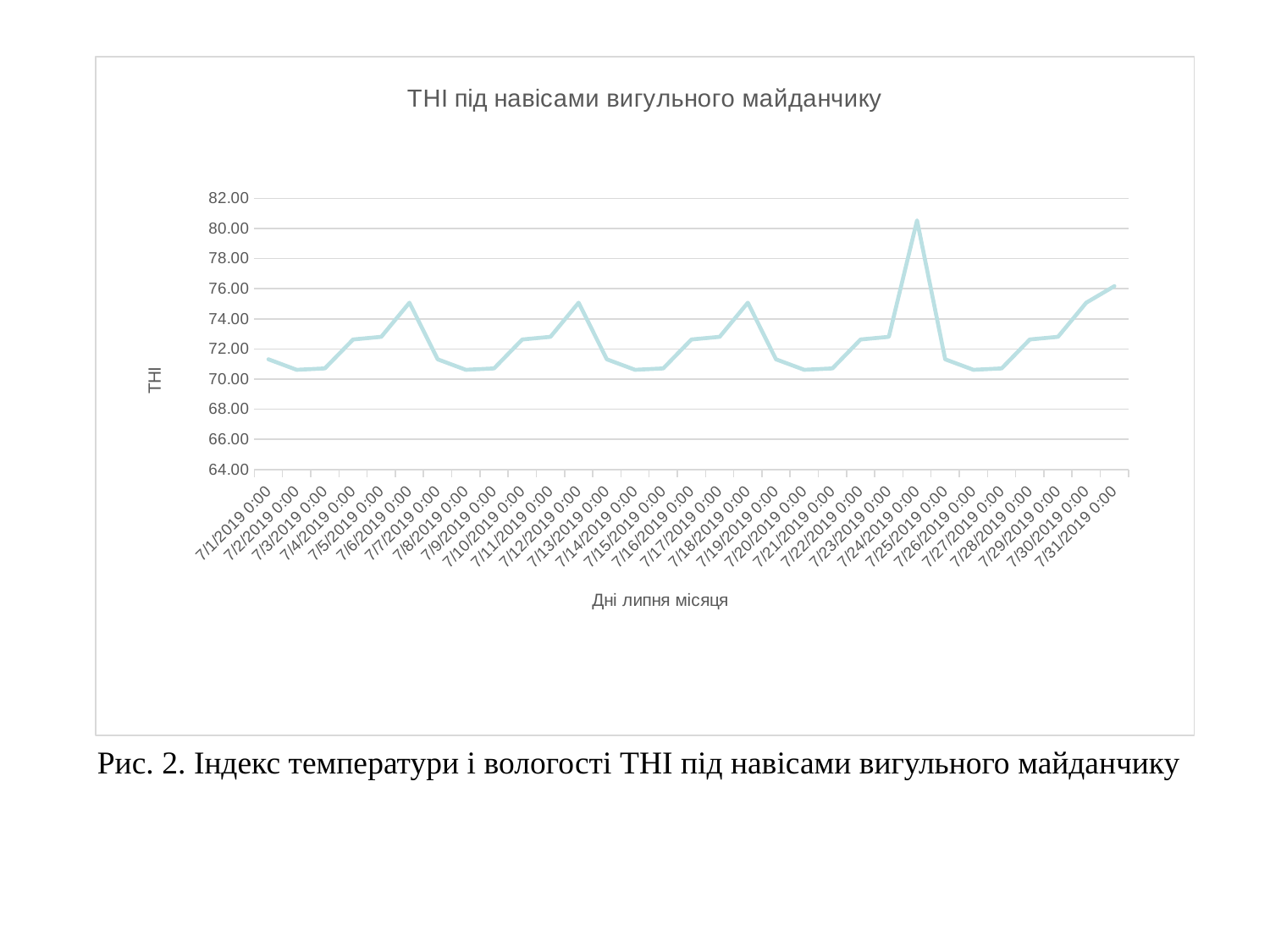
Which is larger, the value for 7/25/2019 0:00 or the value for 7/6/2019 0:00? 7/6/2019 0:00 What kind of chart is shown on the slide? line chart What is the label of the x axis? Дні липня місяця Is the value for 7/31/2019 0:00 greater or less than 74.00? greater Is the value for 7/6/2019 0:00 greater or less than 74.00? greater What is the title of the chart? THI під навісами вигульного майданчику Is the value for 7/1/2019 0:00 greater or less than 72.00? less How many data points are plotted on the line? 31 Do the values rise or fall from 7/27/2019 0:00 to 7/31/2019 0:00? rise On which date does the THI reach its highest value? 7/24/2019 0:00